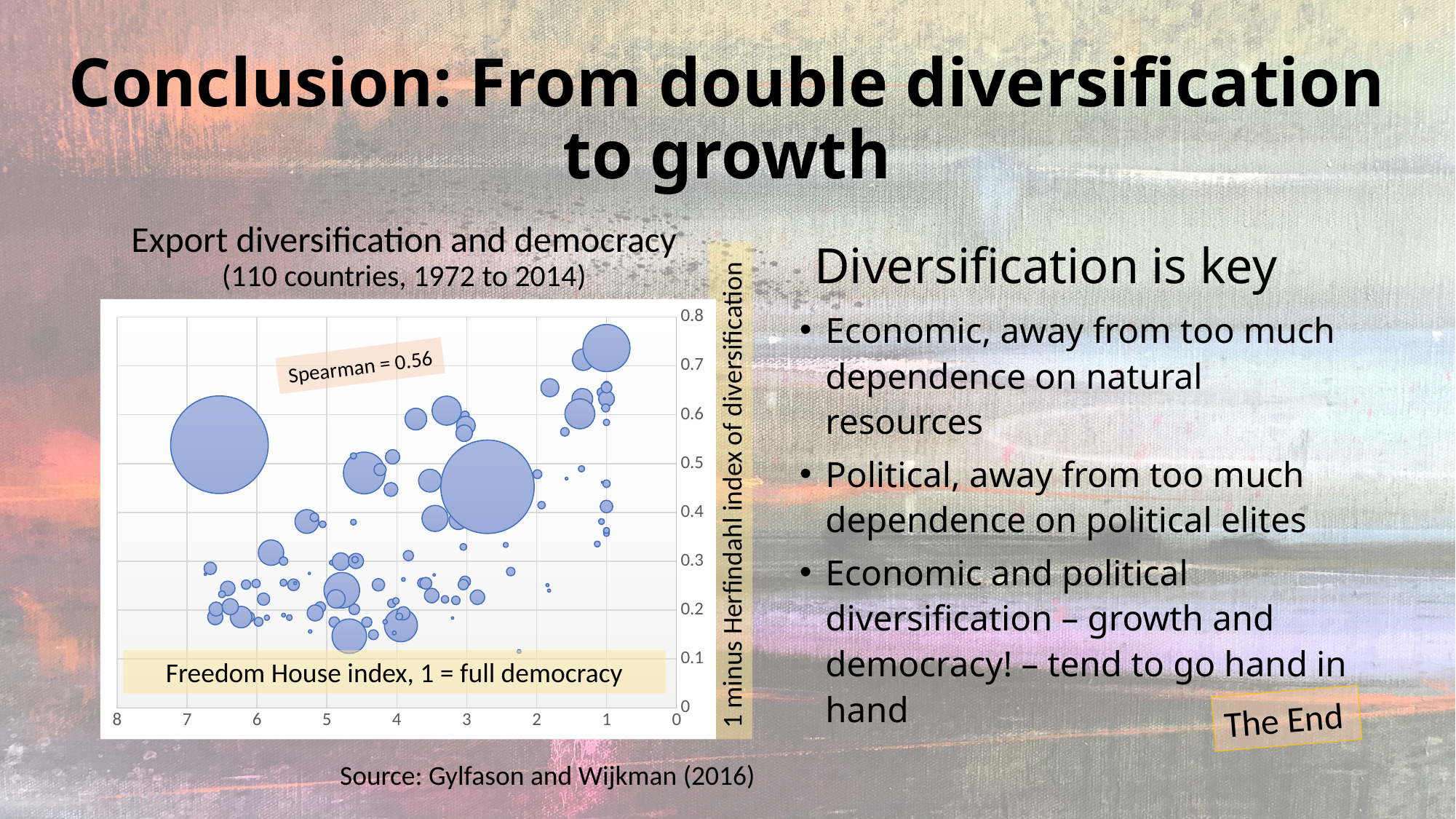
How many countries does the chart cover, according to its title? 110 What Spearman correlation value is printed on the chart? Spearman = 0.56 What is the label of the vertical axis of the chart? 1 minus Herfindahl index of diversification What is the title of the chart on the slide? Export diversification and democracy (110 countries, 1972 to 2014) What kind of chart is shown on the slide? Bubble chart Do the bubbles tend to sit higher on the vertical axis as the Freedom House index moves toward 1 (the right side of the chart)? Yes, they rise What is the leftmost tick value shown on the horizontal axis of the chart? 8 What is the highest tick value shown on the vertical axis of the chart? 0.8